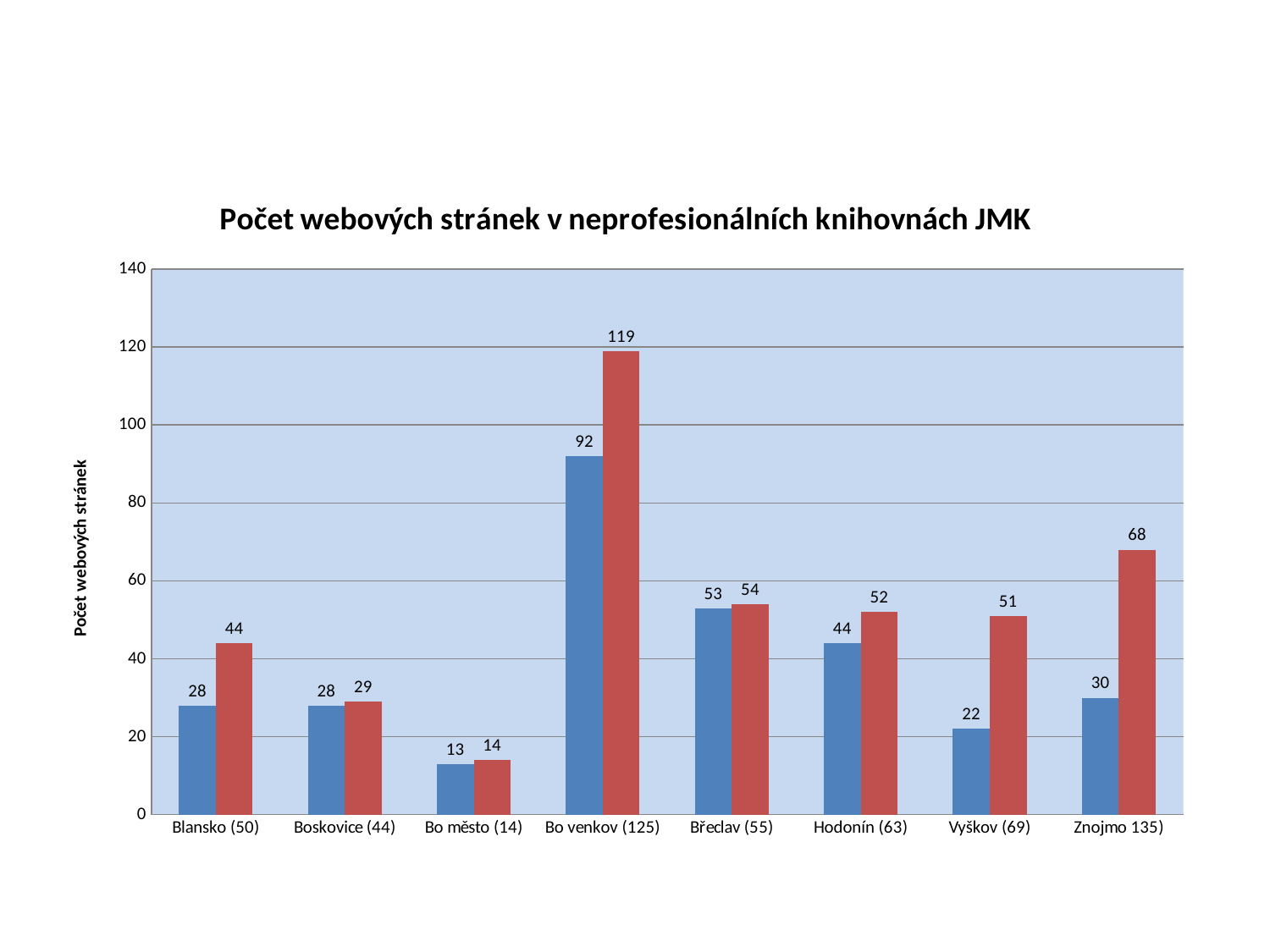
Which category has the highest blue bar? Bo venkov (125) What is the value of the red bar for Znojmo 135)? 68 Which category has the lowest red bar? Bo město (14) What is the difference between the red bar for Bo venkov (125) and the blue bar for Bo venkov (125)? 27 What kind of chart is shown on the slide? bar chart How many categories are shown on the x axis? 8 Is the value of the red bar for Bo venkov (125) greater or less than 100? greater Which is larger: the red bar for Blansko (50) or the red bar for Hodonín (63)? Hodonín (63) What is the title of the chart? Počet webových stránek v neprofesionálních knihovnách JMK What is the value of the blue bar for Hodonín (63)? 44 What is the value of the red bar for Bo venkov (125)? 119 What is the difference between the red and blue bars for Vyškov (69)? 29